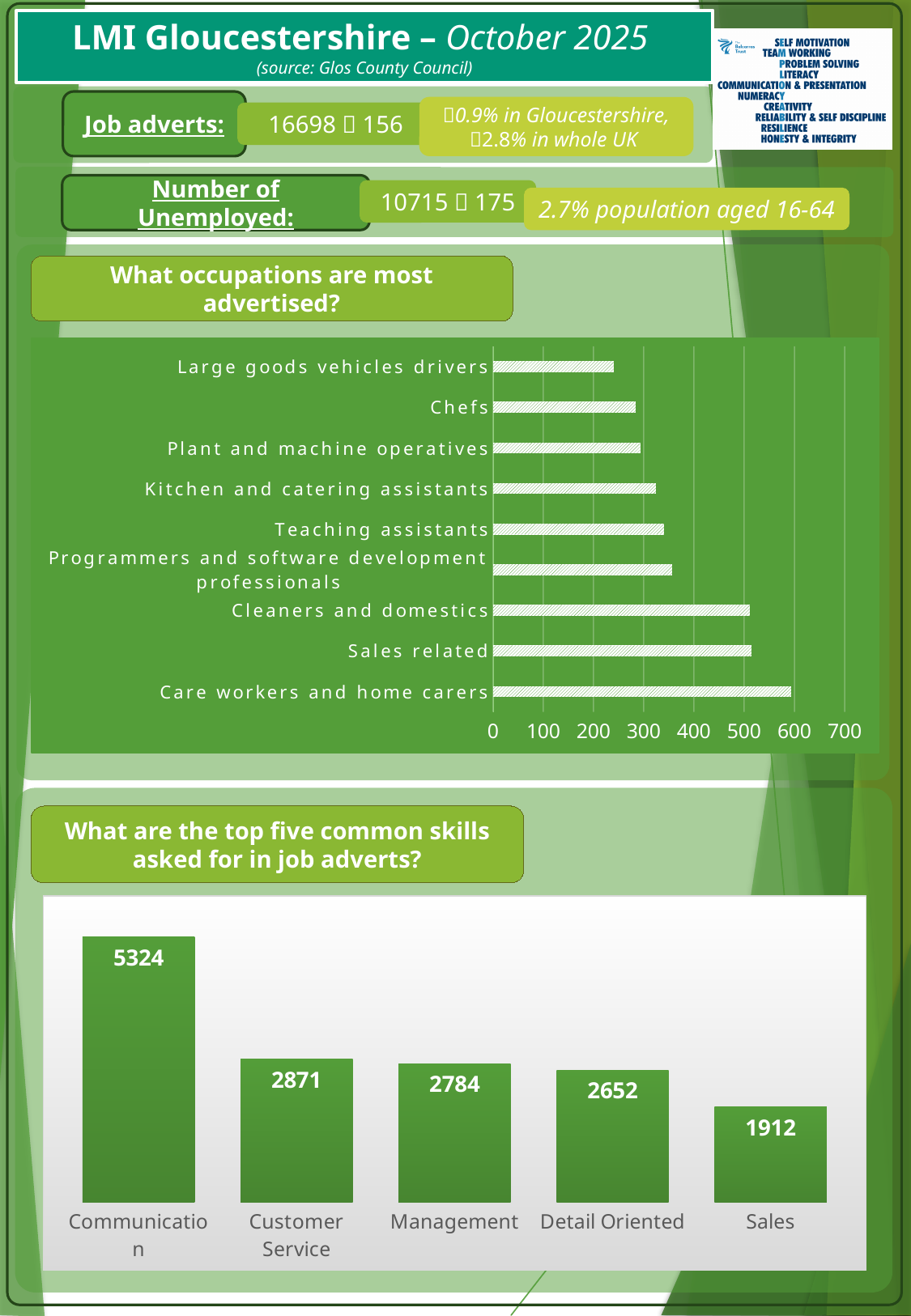
In the 'What are the top five common skills asked for in job adverts?' chart, what is the difference between the values for Customer Service and Management? 87 In the 'What occupations are most advertised?' chart, is the value for Care workers and home carers greater or less than 500? greater In the 'What occupations are most advertised?' chart, which occupation has the lowest value? Large goods vehicles drivers In the 'What are the top five common skills asked for in job adverts?' chart, which skill has the highest value? Communication In the 'What occupations are most advertised?' chart, is the value for Programmers and software development professionals greater or less than 300? greater In the 'What occupations are most advertised?' chart, which is larger, the value for Chefs or the value for Cleaners and domestics? Cleaners and domestics In the 'What occupations are most advertised?' chart, how many occupations are shown? 9 What kind of chart is the 'What are the top five common skills asked for in job adverts?' chart? bar chart In the 'What occupations are most advertised?' chart, which occupation has the highest value? Care workers and home carers In the 'What are the top five common skills asked for in job adverts?' chart, what is the value for Customer Service? 2871 In the 'What are the top five common skills asked for in job adverts?' chart, what is the difference between the values for Communication and Sales? 3412 In the 'What occupations are most advertised?' chart, is the value for Large goods vehicles drivers greater or less than 300? less